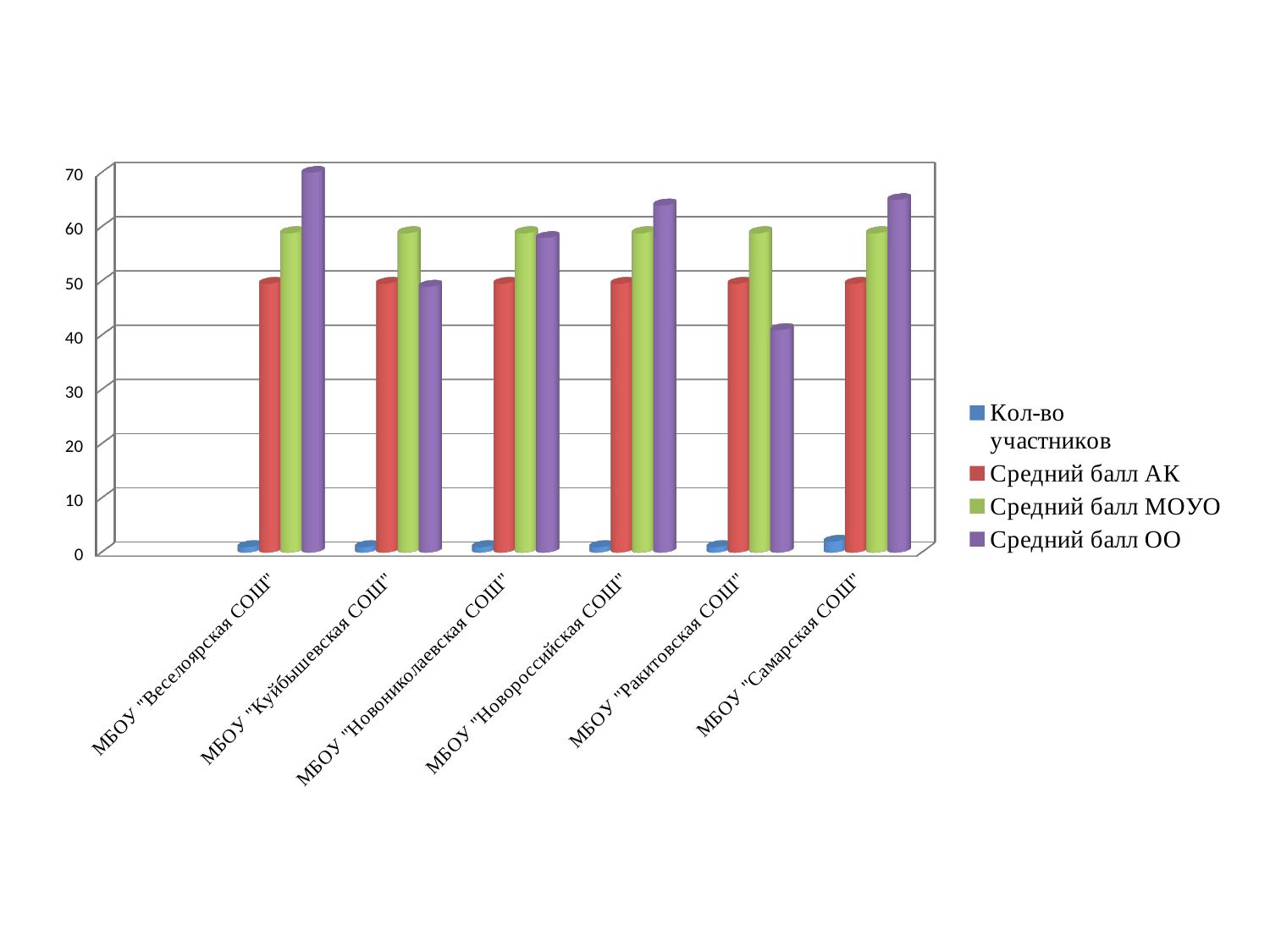
How many series does the legend list? 4 Is the value of Средний балл АК for МБОУ "Самарская СОШ" greater or less than 40? greater Which is larger for МБОУ "Куйбышевская СОШ": Средний балл АК or Средний балл МОУО? Средний балл МОУО Which school has the lowest value for Средний балл ОО? МБОУ "Ракитовская СОШ" What colour represents the series Средний балл ОО in the legend? purple Which school has the highest value for Средний балл ОО? МБОУ "Веселоярская СОШ" Which is larger: Средний балл ОО for МБОУ "Веселоярская СОШ" or for МБОУ "Ракитовская СОШ"? МБОУ "Веселоярская СОШ" Is the value of Средний балл ОО for МБОУ "Ракитовская СОШ" greater or less than 50? less How many schools (categories) are shown on the x axis? 6 Which series has the smallest values across all schools? Кол-во участников Is the value of Средний балл ОО for МБОУ "Веселоярская СОШ" greater or less than 60? greater What kind of chart is shown on the slide? bar chart